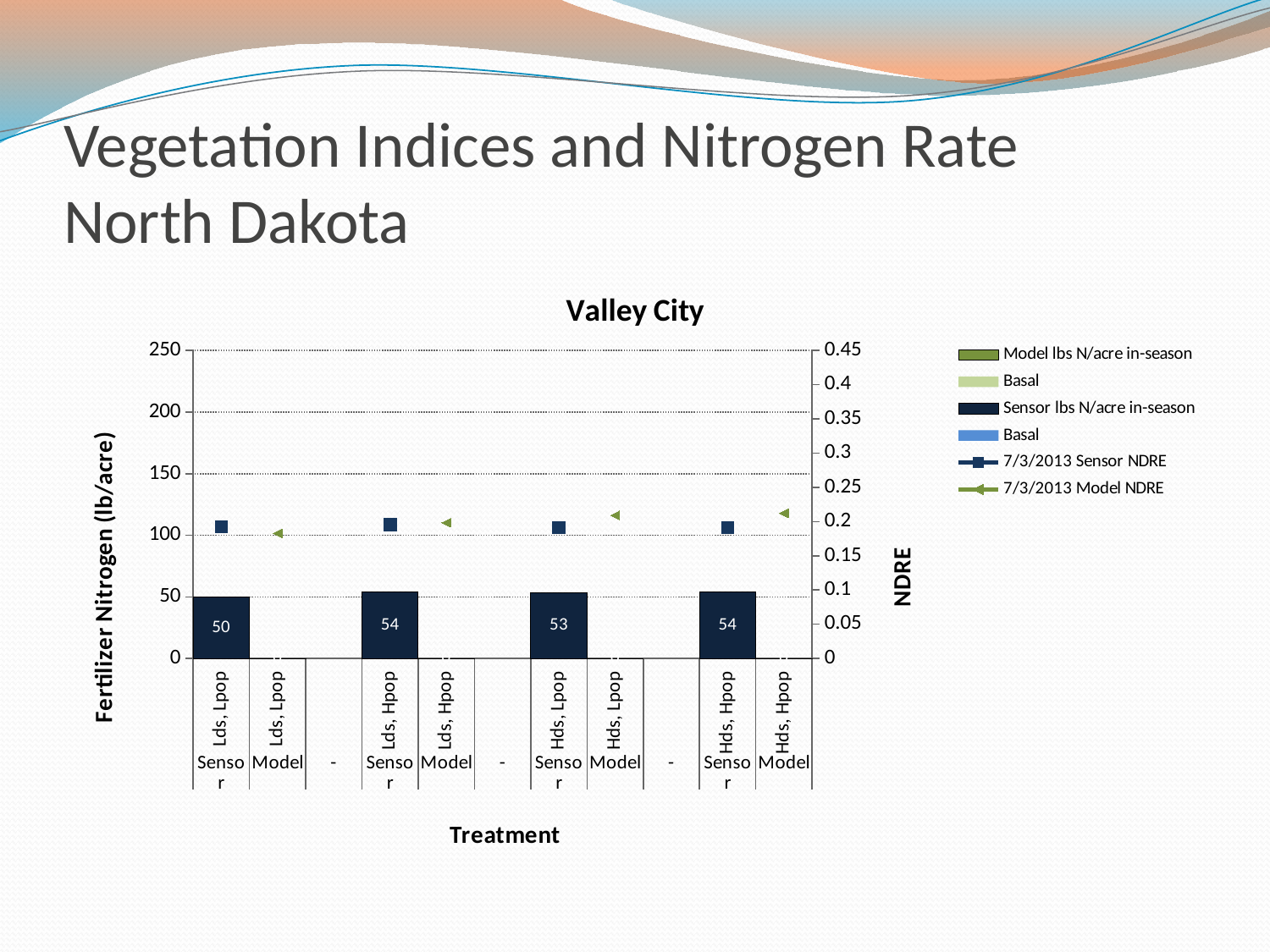
How many Sensor lbs N/acre in-season bars have data labels in the Valley City chart? 4 In the Valley City chart, what is the Sensor lbs N/acre in-season value for the Hds, Lpop treatment? 53 In the Valley City chart, what is the Sensor lbs N/acre in-season value for the Lds, Lpop treatment? 50 In the Valley City chart, is the 7/3/2013 Model NDRE value for Hds, Hpop greater or less than 0.15? greater In the Valley City chart, is the Sensor lbs N/acre in-season value for Hds, Hpop greater or less than 100? less In the Valley City chart, what is the Sensor lbs N/acre in-season value for the Lds, Hpop treatment? 54 What is the label of the right-hand vertical axis in the Valley City chart? NDRE In the Valley City chart, which treatment has the lowest Sensor lbs N/acre in-season bar? Lds, Lpop In the Valley City chart, what is the difference between the Sensor lbs N/acre in-season values for Lds, Hpop and Lds, Lpop? 4 In the Valley City chart, which has the larger Sensor lbs N/acre in-season value: Hds, Lpop or Lds, Hpop? Lds, Hpop How many series does the legend of the Valley City chart list? 6 In the Valley City chart, is the 7/3/2013 Sensor NDRE value for Lds, Lpop greater or less than 0.25? less